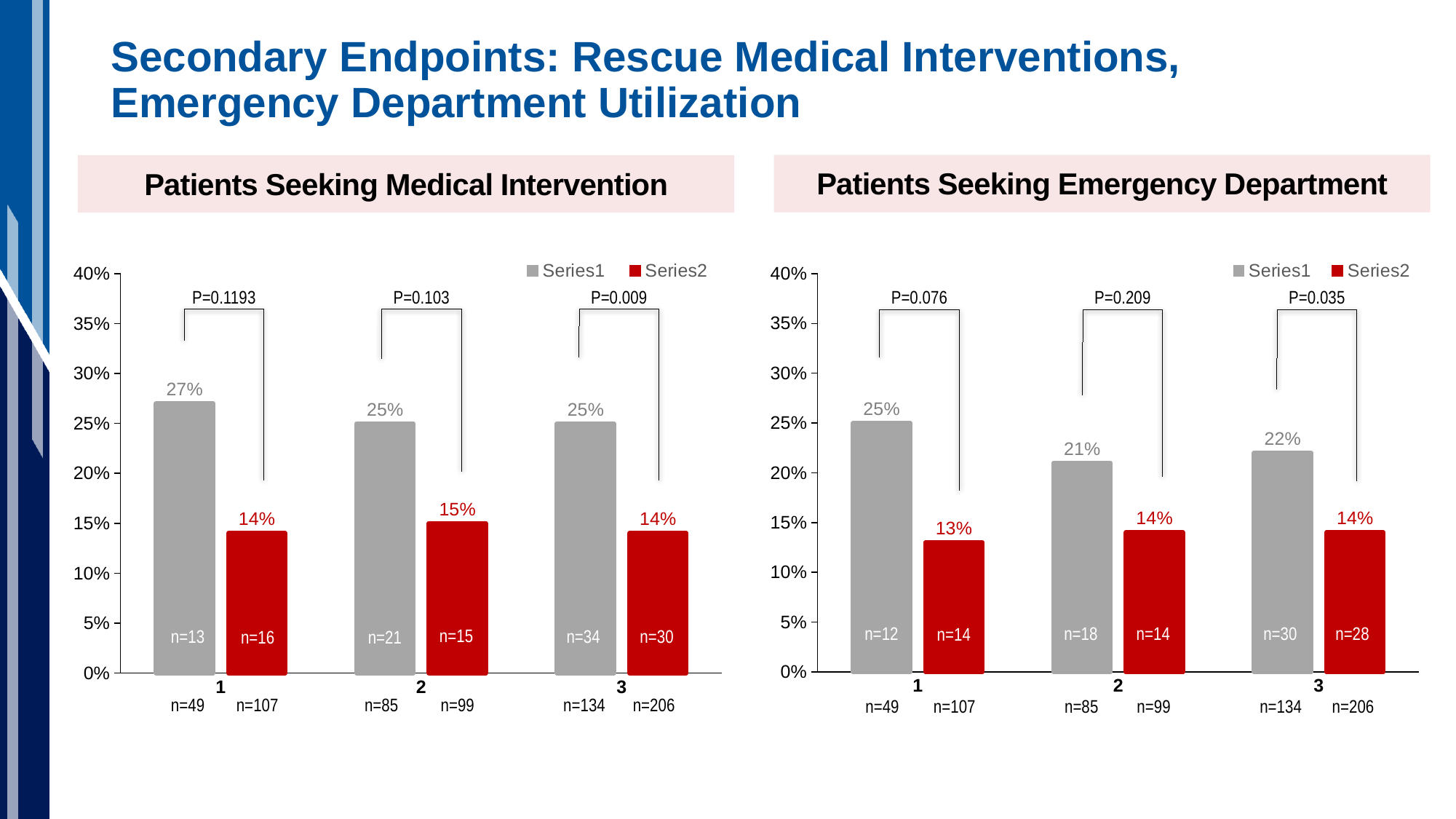
What kind of chart is the 'Patients Seeking Medical Intervention' chart? Bar chart In the 'Patients Seeking Medical Intervention' chart, what is the Series1 value for category 1? 27% In the 'Patients Seeking Emergency Department' chart, what is the Series2 value for category 1? 13% In the 'Patients Seeking Emergency Department' chart, what is the difference between the Series1 and Series2 values for category 3? 8% In the 'Patients Seeking Medical Intervention' chart, which category has the highest Series1 value? 1 In the 'Patients Seeking Medical Intervention' chart, what is the difference between the Series1 and Series2 values for category 1? 13% How many series does the legend list in the 'Patients Seeking Medical Intervention' chart? 2 In the 'Patients Seeking Emergency Department' chart, which category has the lowest Series1 value? 2 In the 'Patients Seeking Emergency Department' chart, what is the Series1 value for category 2? 21% How many categories are shown on the x axis of the 'Patients Seeking Emergency Department' chart? 3 In the 'Patients Seeking Emergency Department' chart, which is larger for category 2, Series1 or Series2? Series1 In the 'Patients Seeking Medical Intervention' chart, what is the Series2 value for category 2? 15%